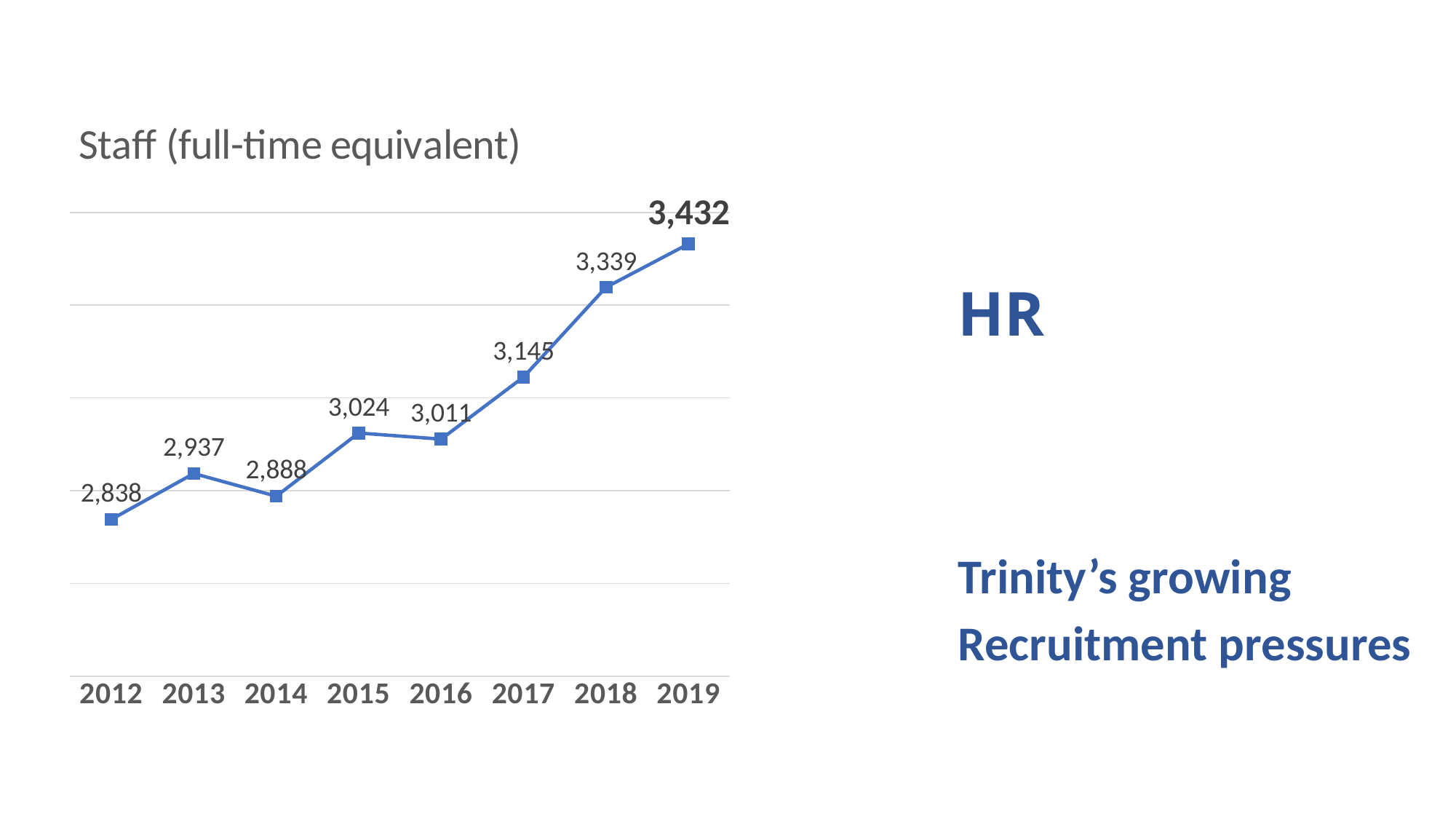
What is the difference between the staff values for 2019 and 2012? 594 What is the staff (full-time equivalent) value for 2019? 3,432 Which year has a larger staff value, 2013 or 2014? 2013 Do the staff values generally rise or fall from 2012 to 2019? Rise Which year has the highest staff (full-time equivalent) value? 2019 What is the staff (full-time equivalent) value for 2012? 2,838 What kind of chart is shown on the slide? Line chart What is the difference between the staff values for 2018 and 2017? 194 Which year has the lowest staff (full-time equivalent) value? 2012 How many years are plotted on the chart? 8 What is the staff (full-time equivalent) value for 2016? 3,011 Which year has a larger staff value, 2015 or 2016? 2015